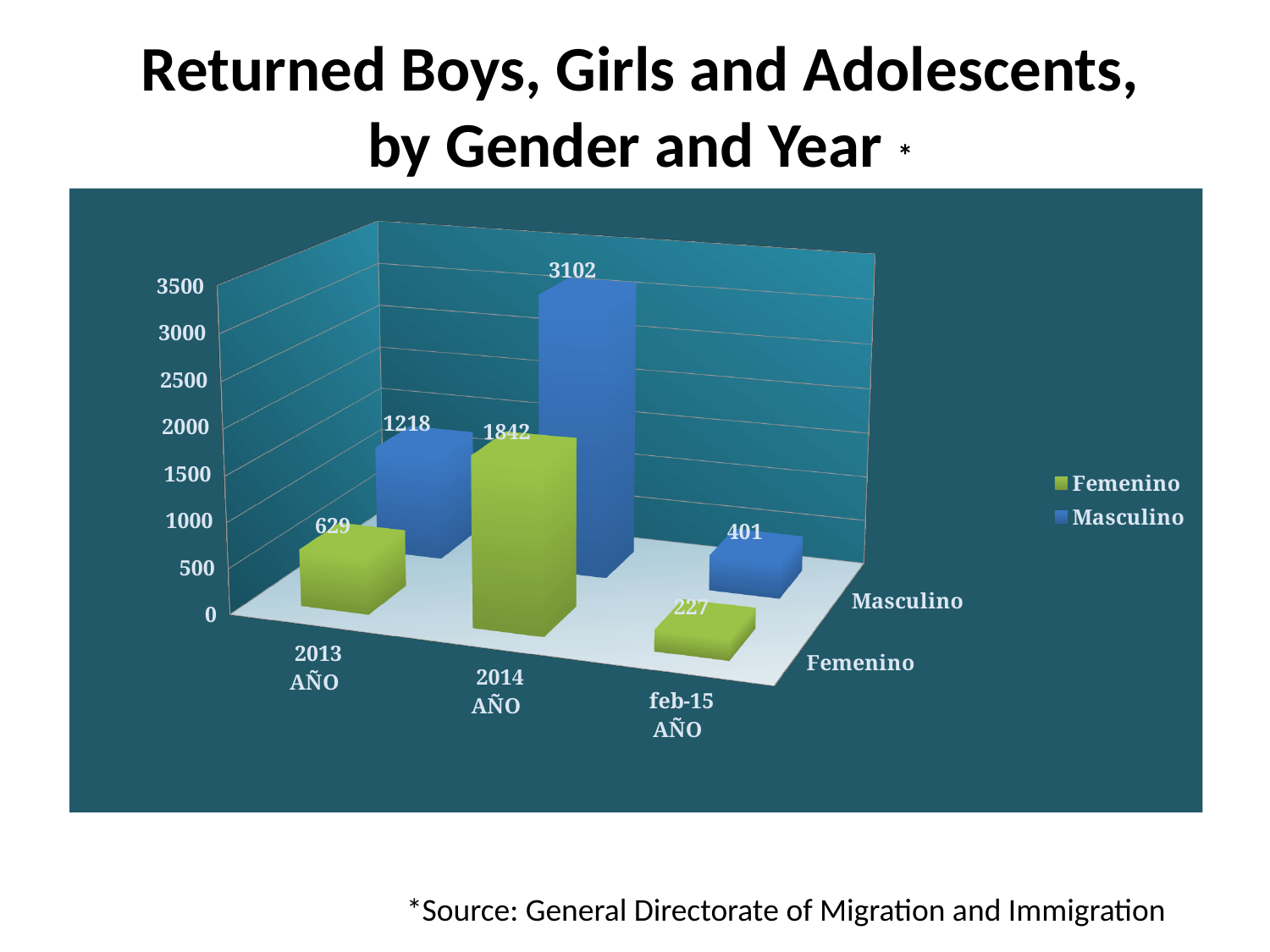
Which colour represents the Masculino series? Blue What is the Masculino value for feb-15? 401 What is the Femenino value for feb-15? 227 Which is larger, the Masculino value for 2013 or the Femenino value for 2014? Femenino value for 2014 Which year has the lowest Femenino value? feb-15 What kind of chart is shown on the slide? Bar chart What is the difference between the Masculino and Femenino values for 2014? 1260 What is the Femenino value for 2013? 629 How many year categories are shown on the x axis? 3 How many series does the legend list? 2 Which year has the highest Masculino value? 2014 What is the Masculino value for 2014? 3102